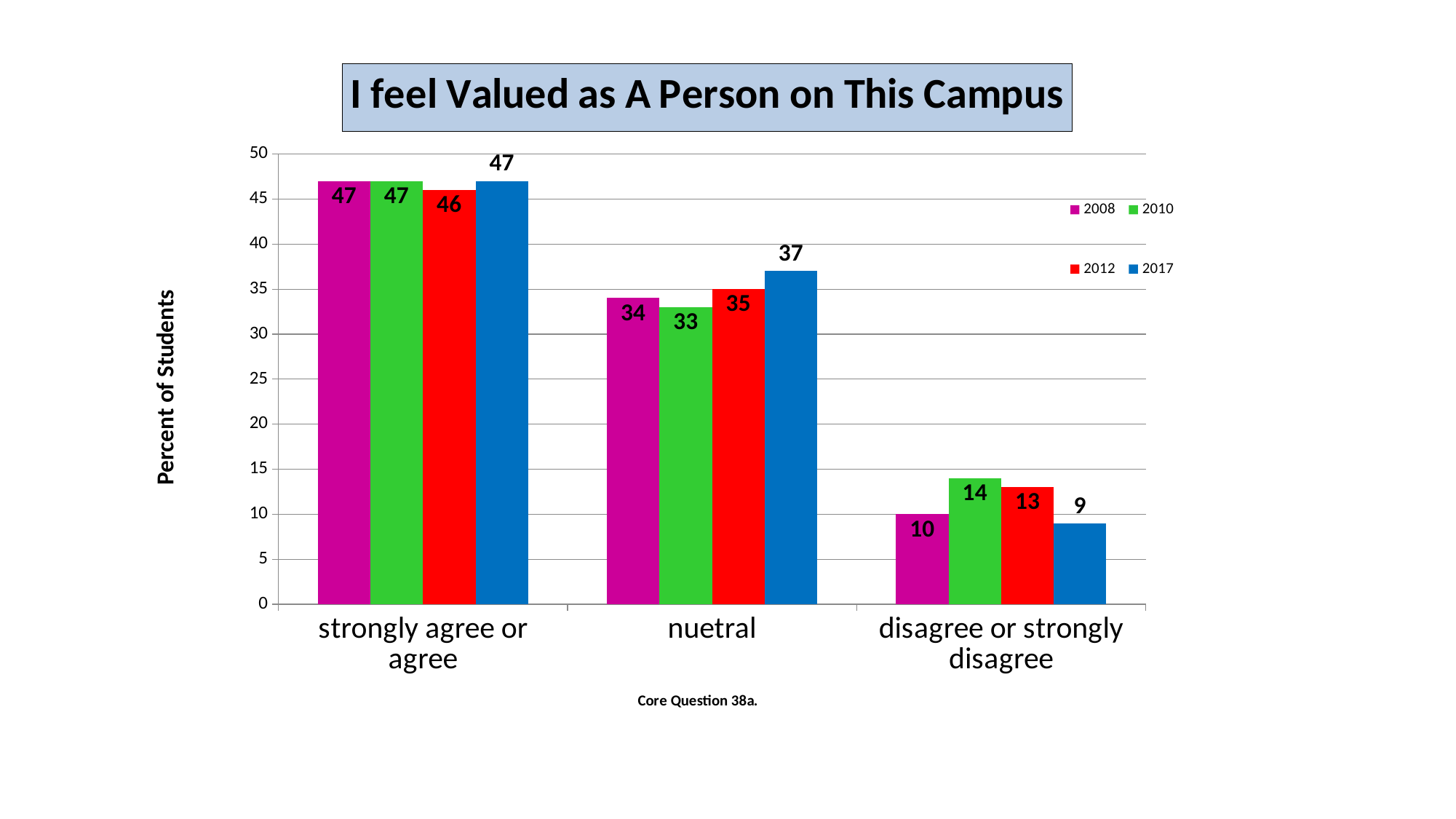
How many categories are shown on the x axis? 3 Which is larger in the 'disagree or strongly disagree' category: the 2008 value or the 2017 value? 2008 What is the difference between the 2017 and 2008 values in the 'nuetral' category? 3 Which year has the highest value in the 'disagree or strongly disagree' category? 2010 What is the value for 2010 in the 'disagree or strongly disagree' category? 14 Which year has the lowest value in the 'nuetral' category? 2010 What kind of chart is shown on the slide? bar chart How many series does the legend list? 4 Is the value for 2012 in the 'nuetral' category greater or less than 30? greater What is the value for 2017 in the 'nuetral' category? 37 What is the value for 2012 in the 'strongly agree or agree' category? 46 What is the title of the chart? I feel Valued as A Person on This Campus